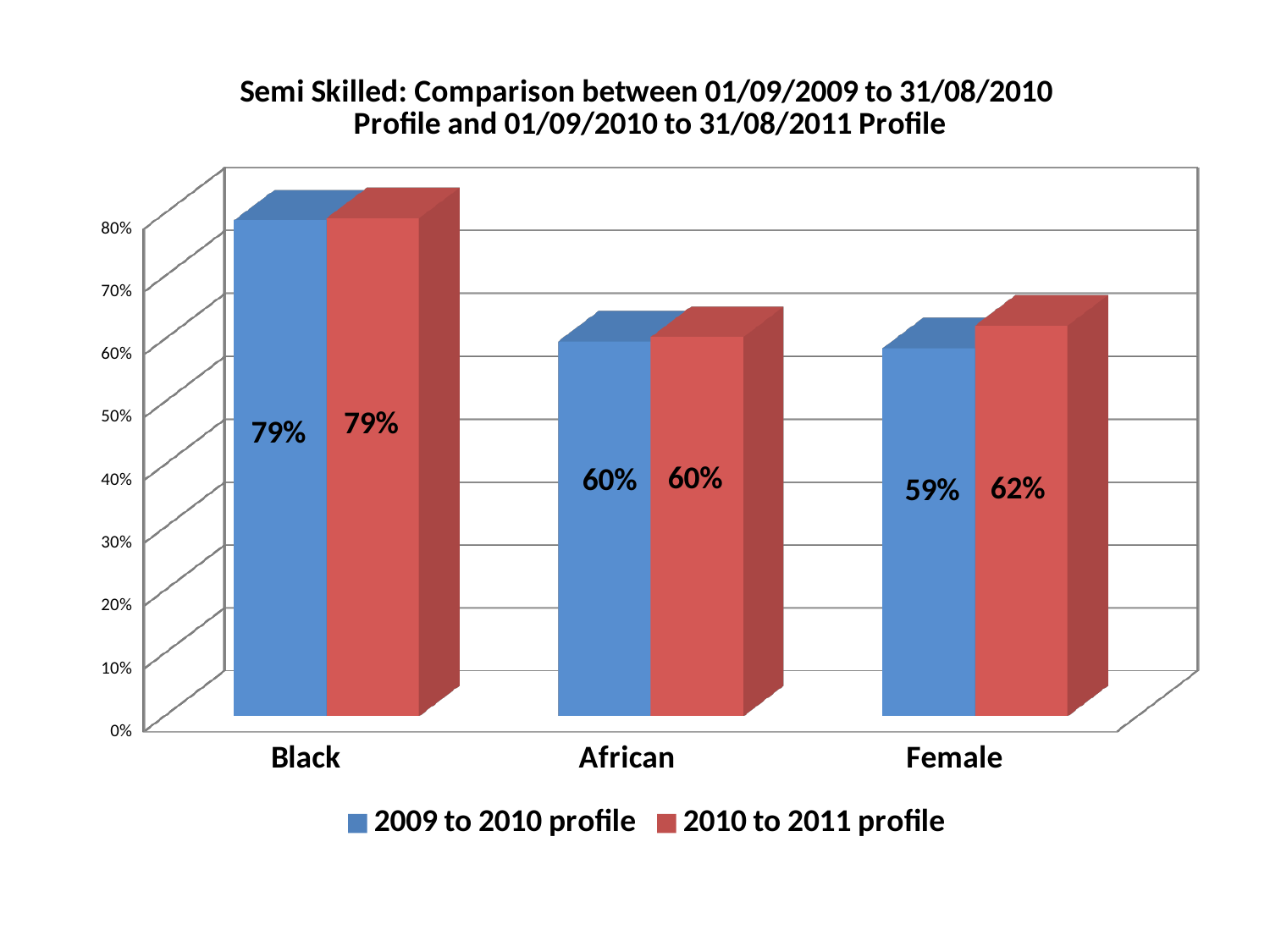
Which category has the lowest value in the 2009 to 2010 profile series? Female What is the value for Female in the 2010 to 2011 profile series? 62% What kind of chart is shown on the slide? Bar chart Which category has the highest value in the 2010 to 2011 profile series? Black What is the value for Black in the 2009 to 2010 profile series? 79% How many series does the legend list? 2 What is the value for Female in the 2009 to 2010 profile series? 59% What is the value for African in the 2009 to 2010 profile series? 60% What is the difference between the 2010 to 2011 profile and the 2009 to 2010 profile values for Female? 3% For Female, which series has the larger value: 2009 to 2010 profile or 2010 to 2011 profile? 2010 to 2011 profile How many categories are shown on the x axis? 3 What is the difference between the Black and African values in the 2009 to 2010 profile series? 19%